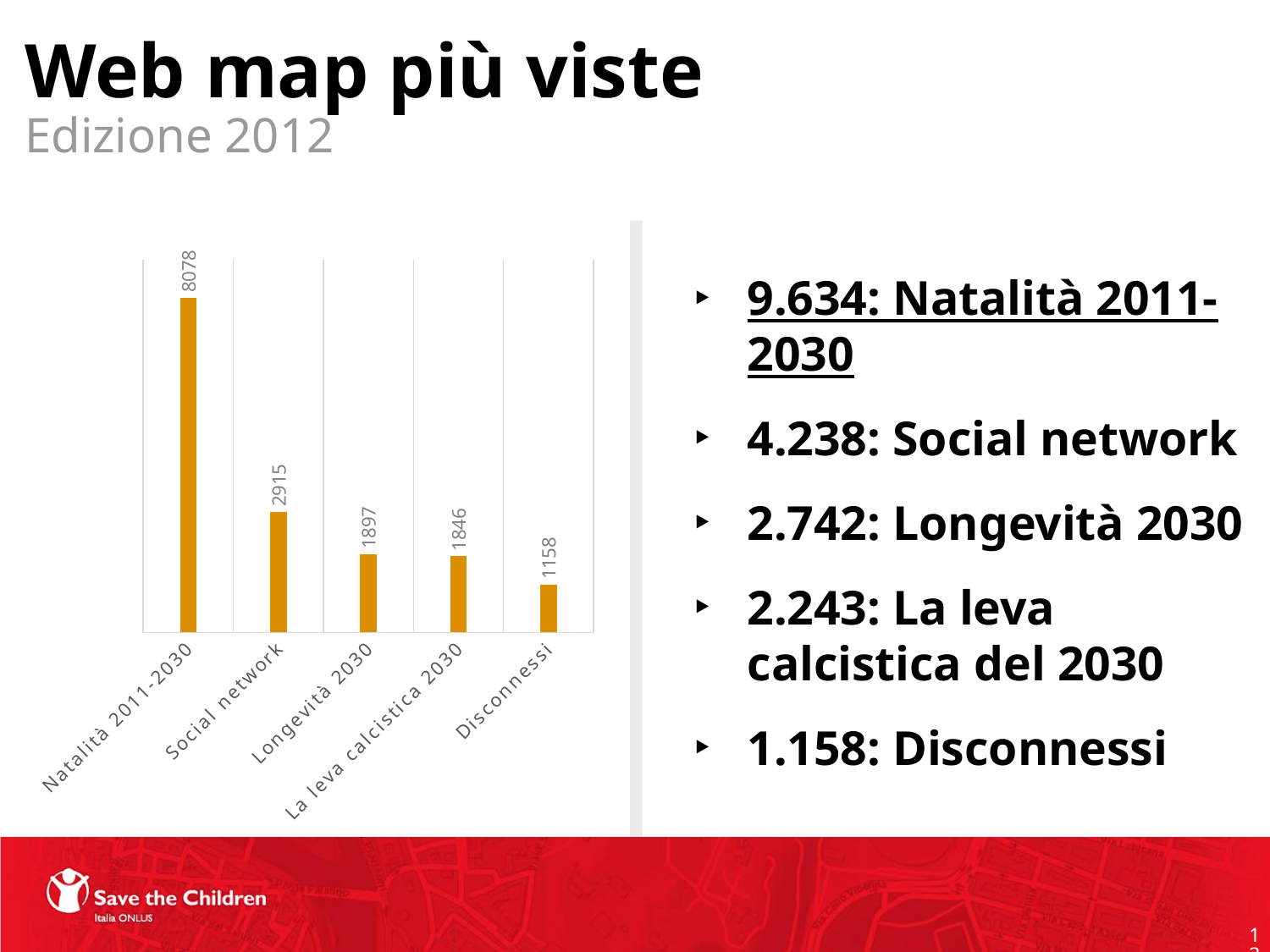
What is the difference between the values for Natalità 2011-2030 and Social network in the chart? 5163 What is the value shown for La leva calcistica 2030 in the chart? 1846 What is the value shown for Disconnessi in the chart? 1158 What type of chart is shown on the slide? Bar chart What is the value shown for Social network in the chart? 2915 Which has a larger value in the chart, Social network or Disconnessi? Social network What is the value shown for Longevità 2030 in the chart? 1897 Do the values in the chart rise or fall from left to right along the x axis? Fall What is the value shown for Natalità 2011-2030 in the chart? 8078 Which category has the highest value in the chart? Natalità 2011-2030 Which category has the lowest value in the chart? Disconnessi How many categories are plotted in the chart? 5